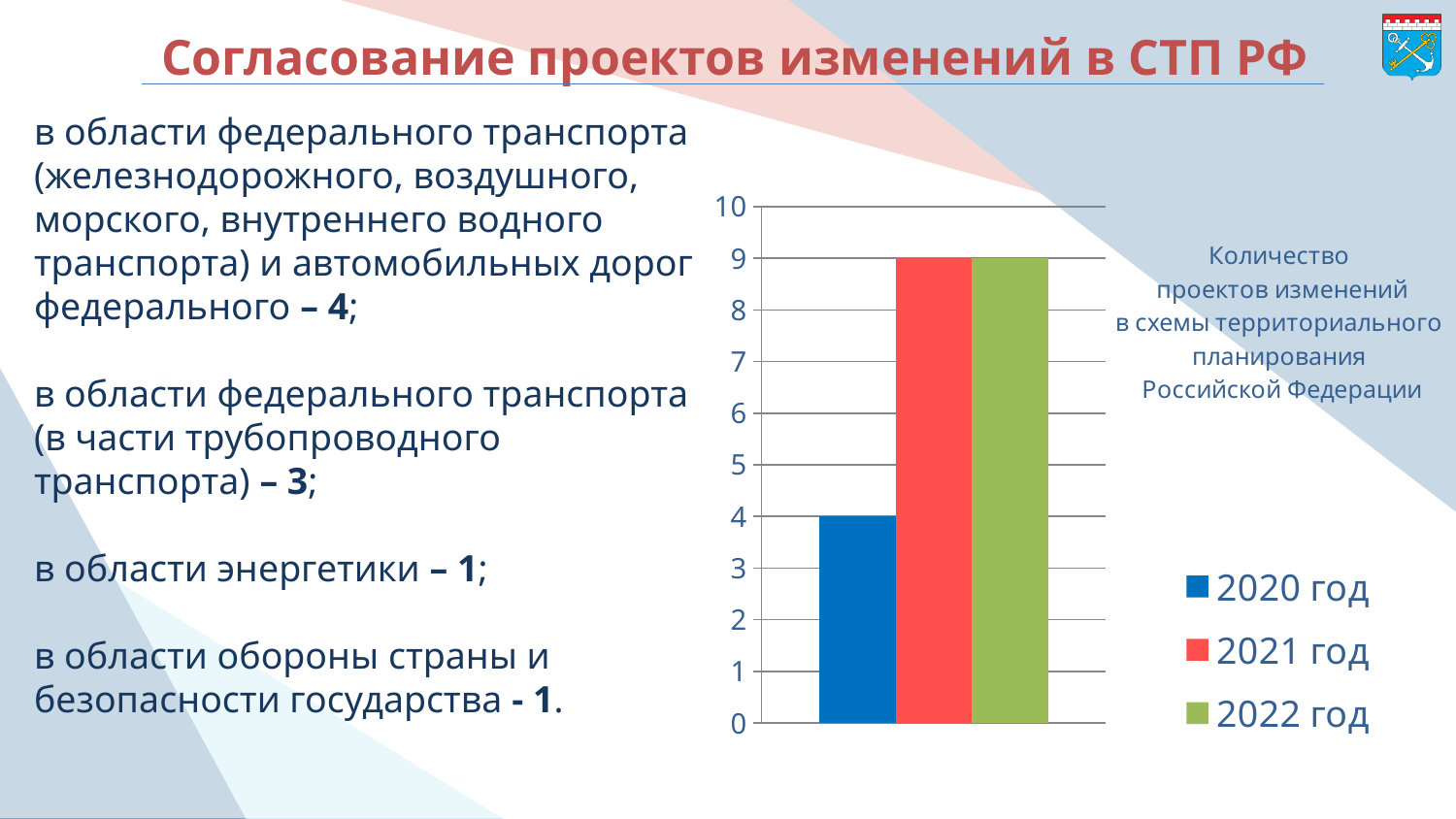
What is the value for 2022 год in the chart? 9 What colour is the bar for 2021 год? red How many bars are plotted in the chart? 3 What is the difference between the values for 2021 год and 2020 год? 5 Which is larger, the value for 2020 год or the value for 2022 год? 2022 год Is the value for 2020 год greater or less than 5? less Which year has the lowest value in the chart? 2020 год How many series does the legend list? 3 What is the value for 2020 год in the chart? 4 What type of chart is shown on the slide? bar chart What is the value for 2021 год in the chart? 9 Is the value for 2021 год greater or less than 8? greater